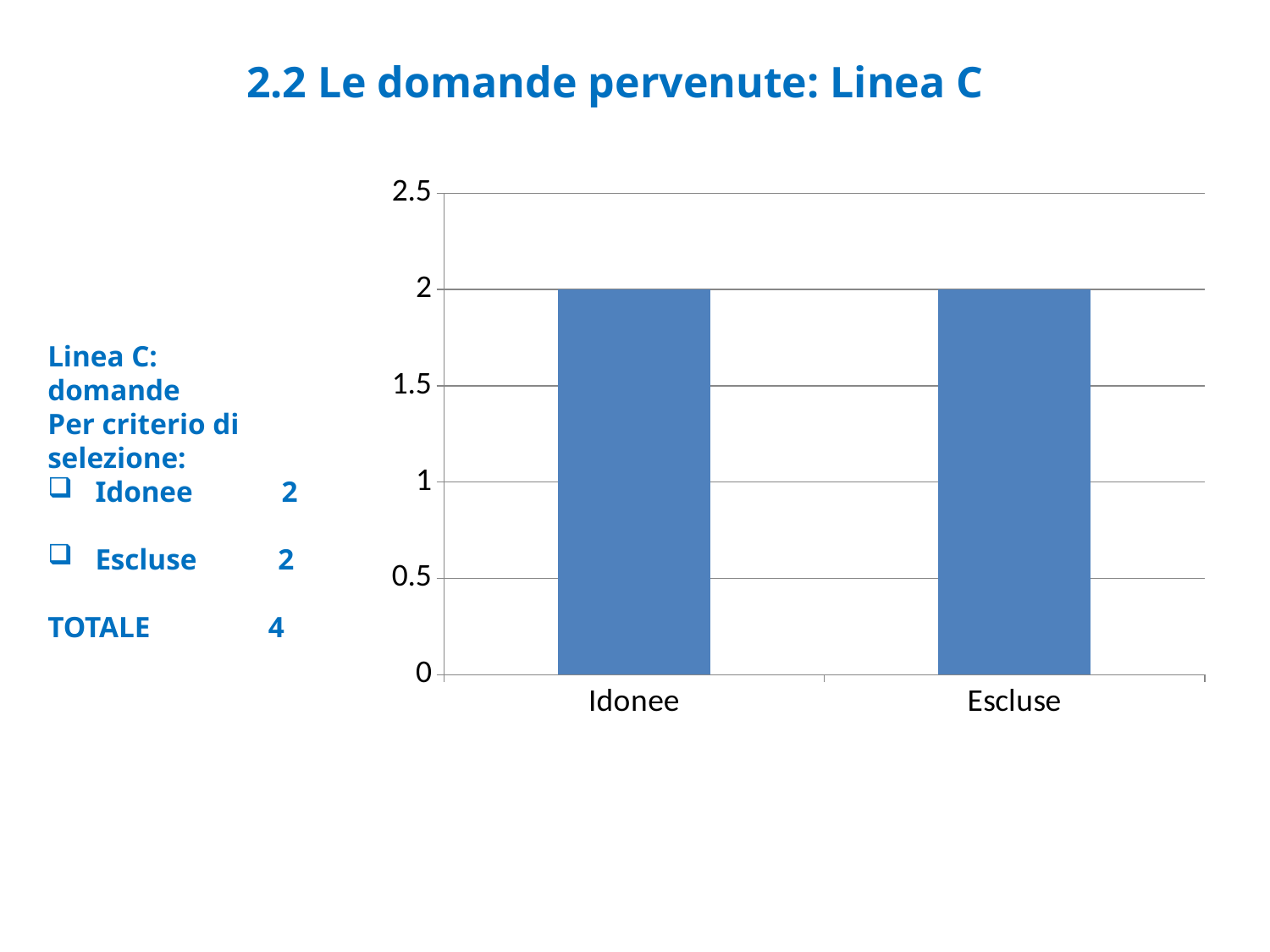
What is the difference between the values for Idonee and Escluse? 0 How many categories are shown on the x axis? 2 What is the total of the values for Idonee and Escluse? 4 Is the value for Idonee greater or less than 1.5? greater What is the highest value shown on the y axis? 2.5 What kind of chart is shown on the slide? bar chart What is the value for Escluse? 2 What is the value for Idonee? 2 Is the value for Escluse greater or less than 2.5? less What is the title of the slide containing the chart? 2.2 Le domande pervenute: Linea C